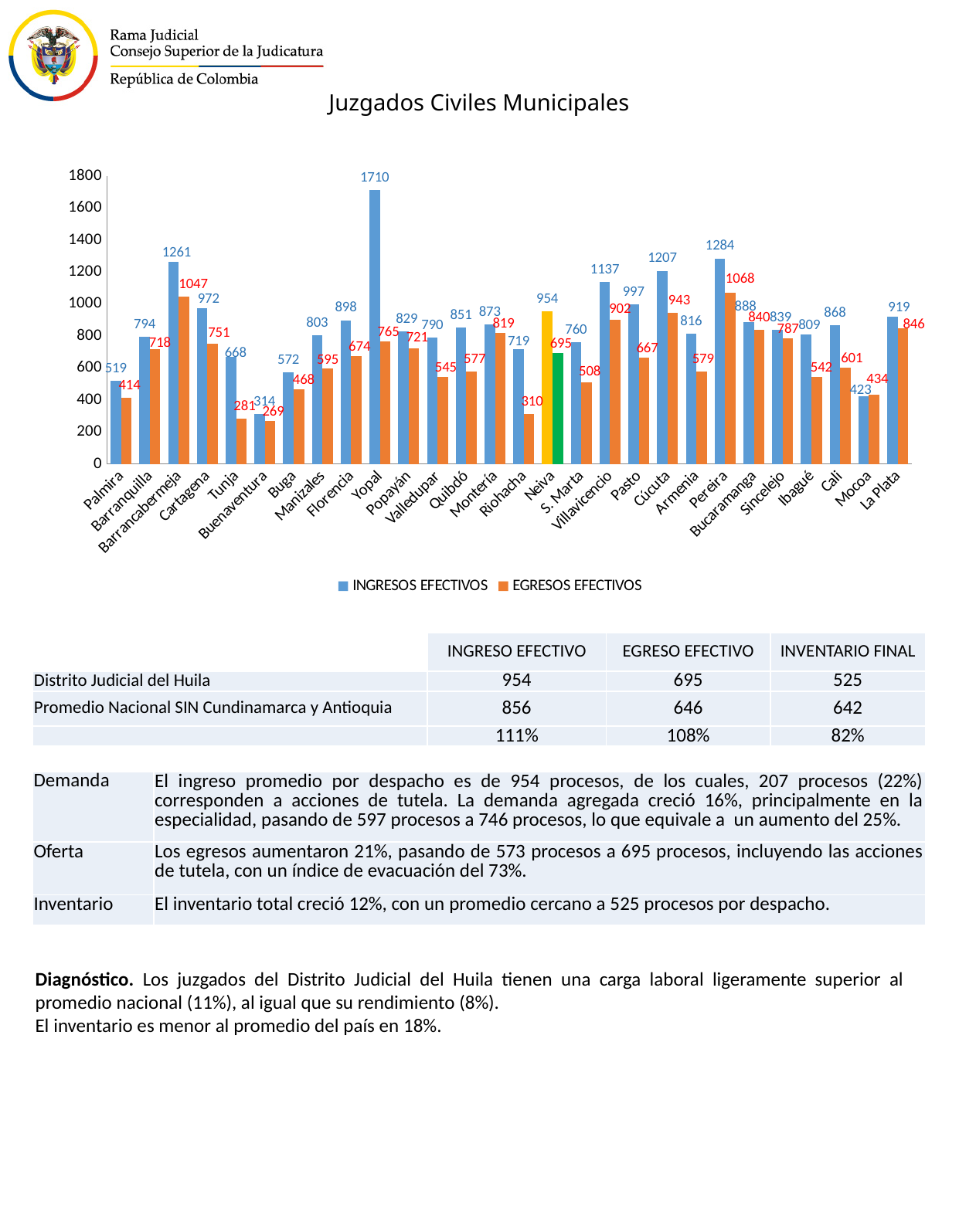
What is the EGRESOS EFECTIVOS value for Neiva? 695 Which category has the highest EGRESOS EFECTIVOS value? Pereira What type of chart is shown on the slide? Bar chart Which category has the lowest EGRESOS EFECTIVOS value? Buenaventura What is the INGRESOS EFECTIVOS value for Yopal? 1710 Is the INGRESOS EFECTIVOS value for Cúcuta greater or less than 1000? greater Which is larger for Mocoa: INGRESOS EFECTIVOS or EGRESOS EFECTIVOS? EGRESOS EFECTIVOS How many categories are shown on the x axis of the chart? 28 How many series does the chart legend list? 2 Which category has the highest INGRESOS EFECTIVOS value? Yopal What is the INGRESOS EFECTIVOS value for Pereira? 1284 What is the difference between INGRESOS EFECTIVOS and EGRESOS EFECTIVOS for Tunja? 387